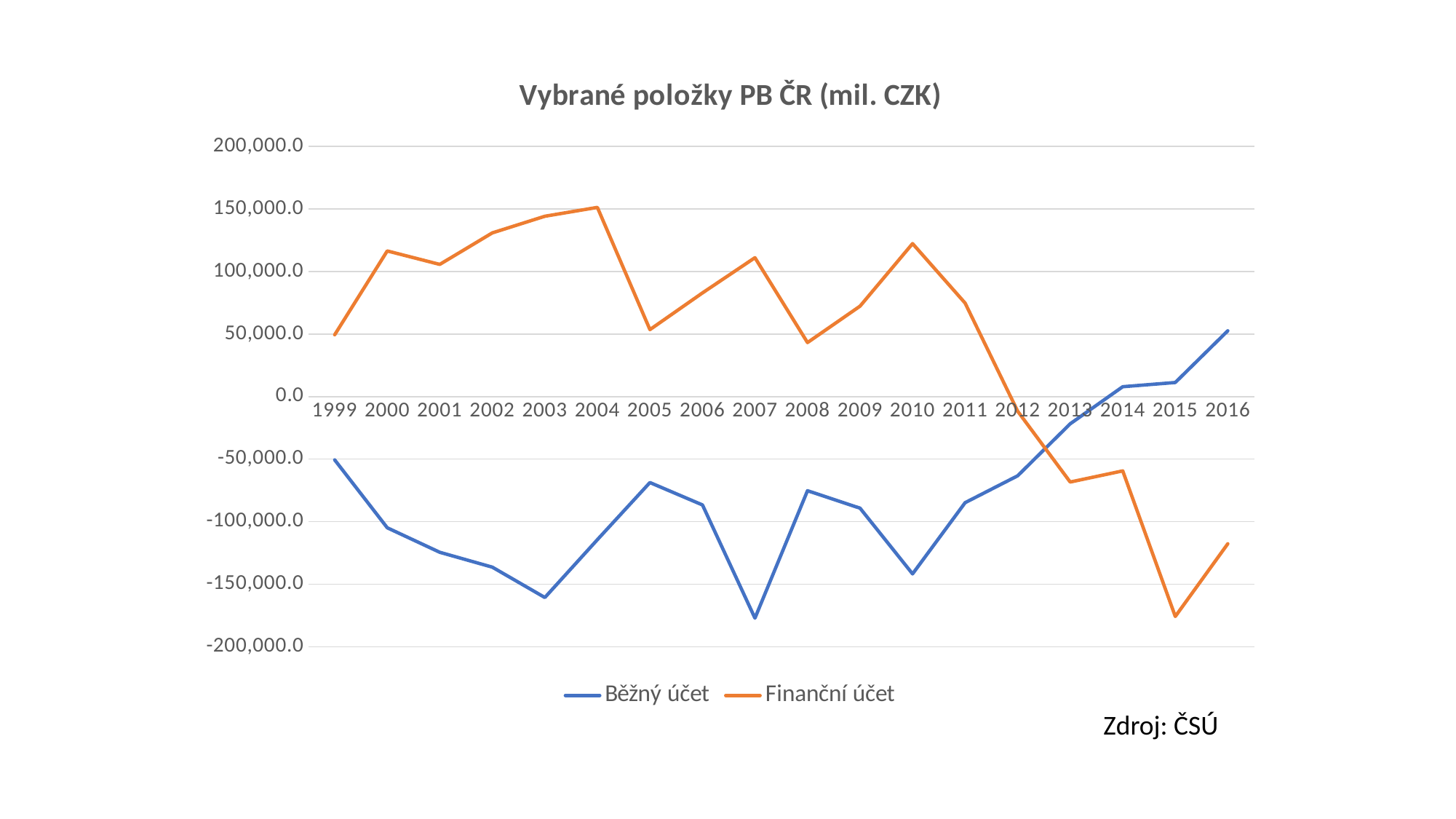
In which year does the Finanční účet series reach its lowest value? 2015 In which year does the Běžný účet series reach its highest value? 2016 In which year does the Běžný účet series reach its lowest value? 2007 Is the value for Finanční účet in 2003 greater or less than 100,000.0? greater How many years are plotted along the x axis? 18 Is the value for Běžný účet in 2007 greater or less than -150,000.0? less What kind of chart is shown on the slide? line chart Which series has the larger value in 2010, Běžný účet or Finanční účet? Finanční účet How many series does the legend list? 2 In which year does the Finanční účet series reach its highest value? 2004 Does the Běžný účet series rise or fall from 2010 to 2016? rise What is the title of the chart? Vybrané položky PB ČR (mil. CZK)